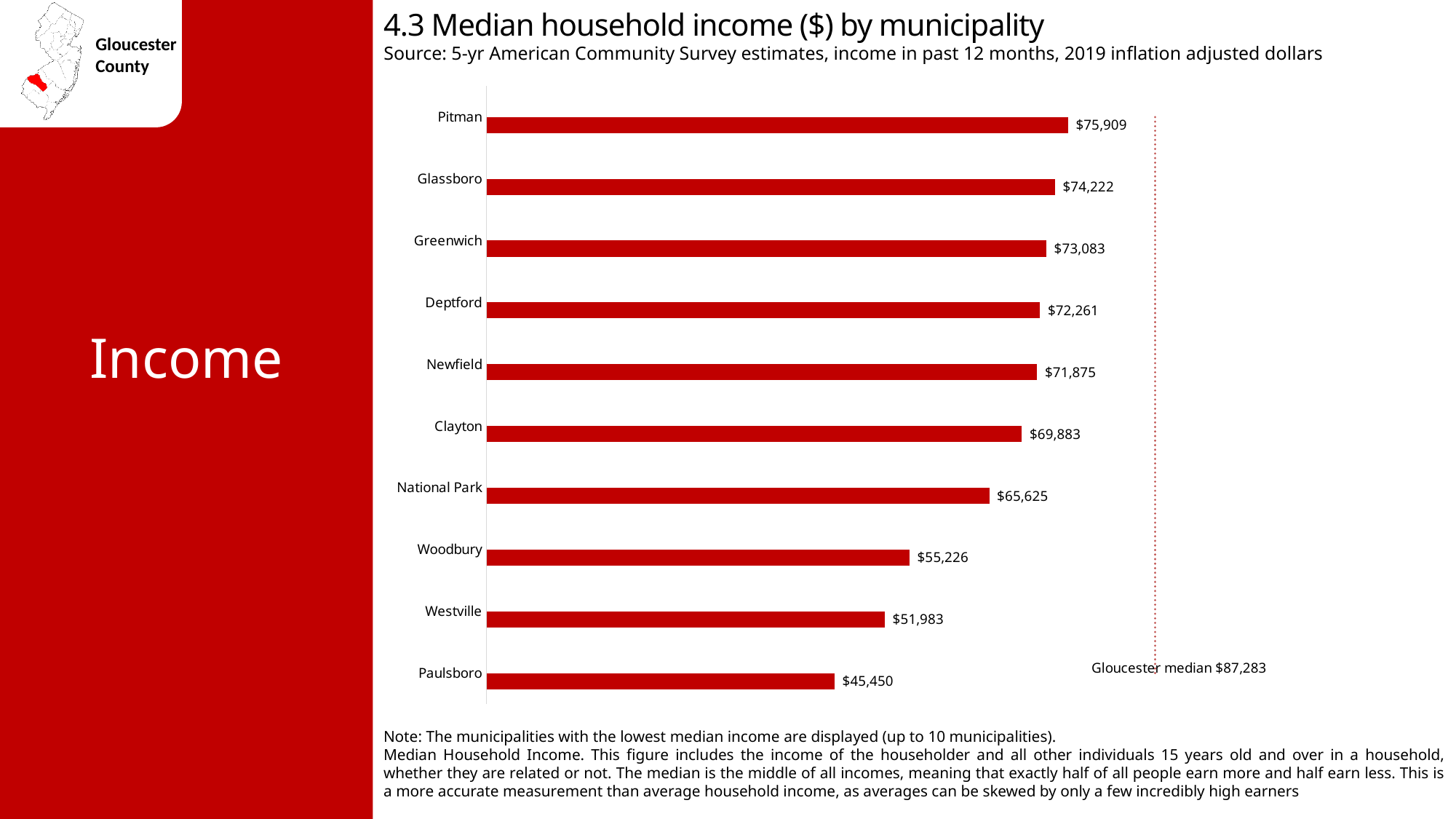
What is the title of the chart? 4.3 Median household income ($) by municipality What is the median household income for Paulsboro? $45,450 Which municipality has the highest median household income shown on the chart? Pitman Which municipality has the lowest median household income shown on the chart? Paulsboro Which has a higher median household income, Clayton or Woodbury? Clayton What is the median household income for National Park? $65,625 What is the difference between the Gloucester median and Pitman's median household income? $11,374 What is the difference between the median household income of Woodbury and Westville? $3,243 How many municipalities are shown on the chart? 10 What is the Gloucester median household income indicated by the dotted line? $87,283 What is the median household income for Pitman? $75,909 What kind of chart is shown on the slide? Bar chart